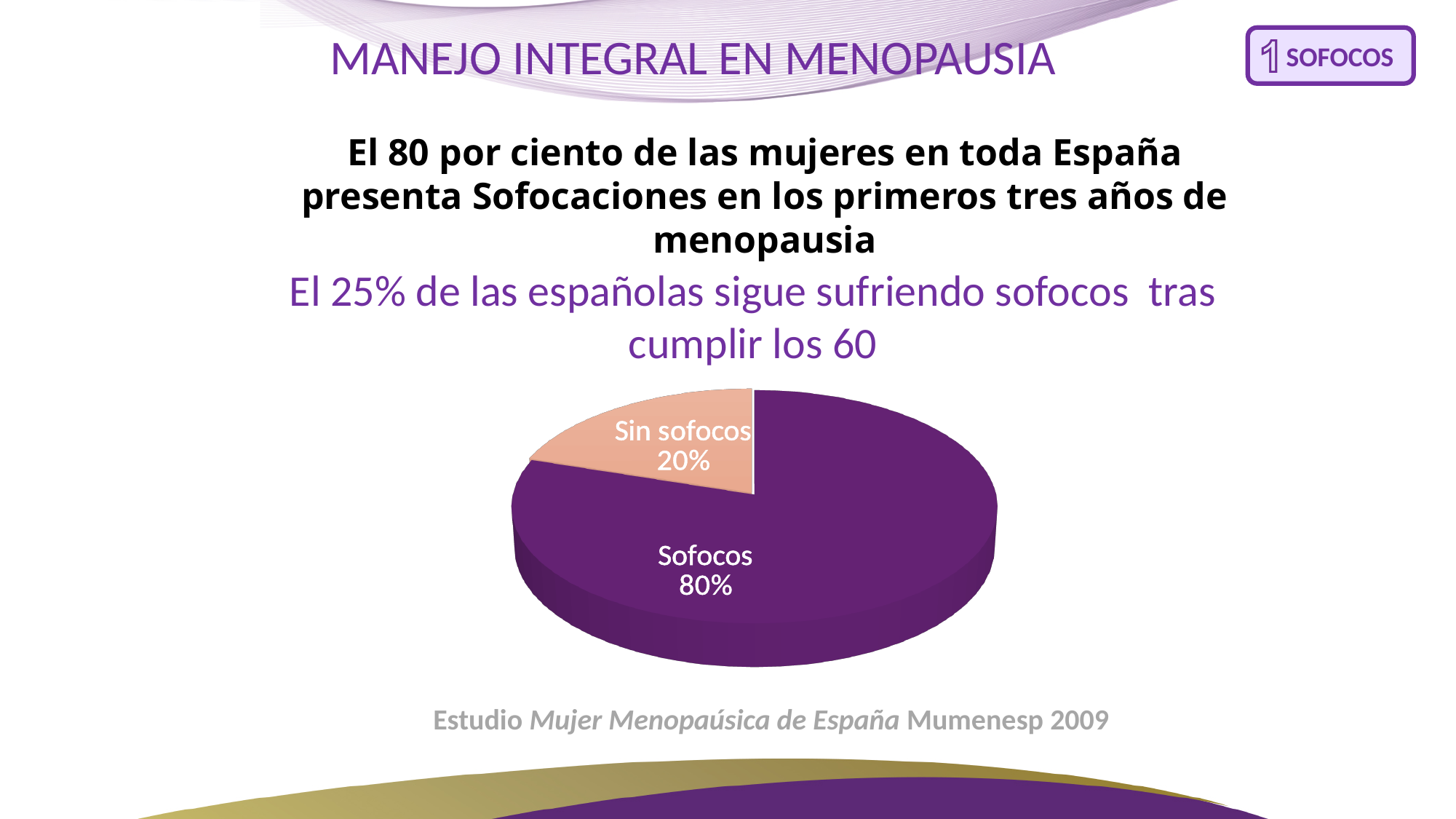
What kind of chart is shown on the slide? pie chart Which slice is larger, "Sofocos" or "Sin sofocos"? Sofocos Which slice of the pie is the largest? Sofocos What is the difference in percentage points between the "Sofocos" and "Sin sofocos" slices? 60 What percentage of the pie is labelled "Sin sofocos"? 20% Which slice of the pie is the smallest? Sin sofocos What share of the pie does the "Sin sofocos" slice represent? 20% What percentage of the pie is labelled "Sofocos"? 80% How many slices does the pie chart have? 2 What colour is the "Sofocos" slice of the pie? purple What is the source cited below the pie chart? Estudio Mujer Menopaúsica de España Mumenesp 2009